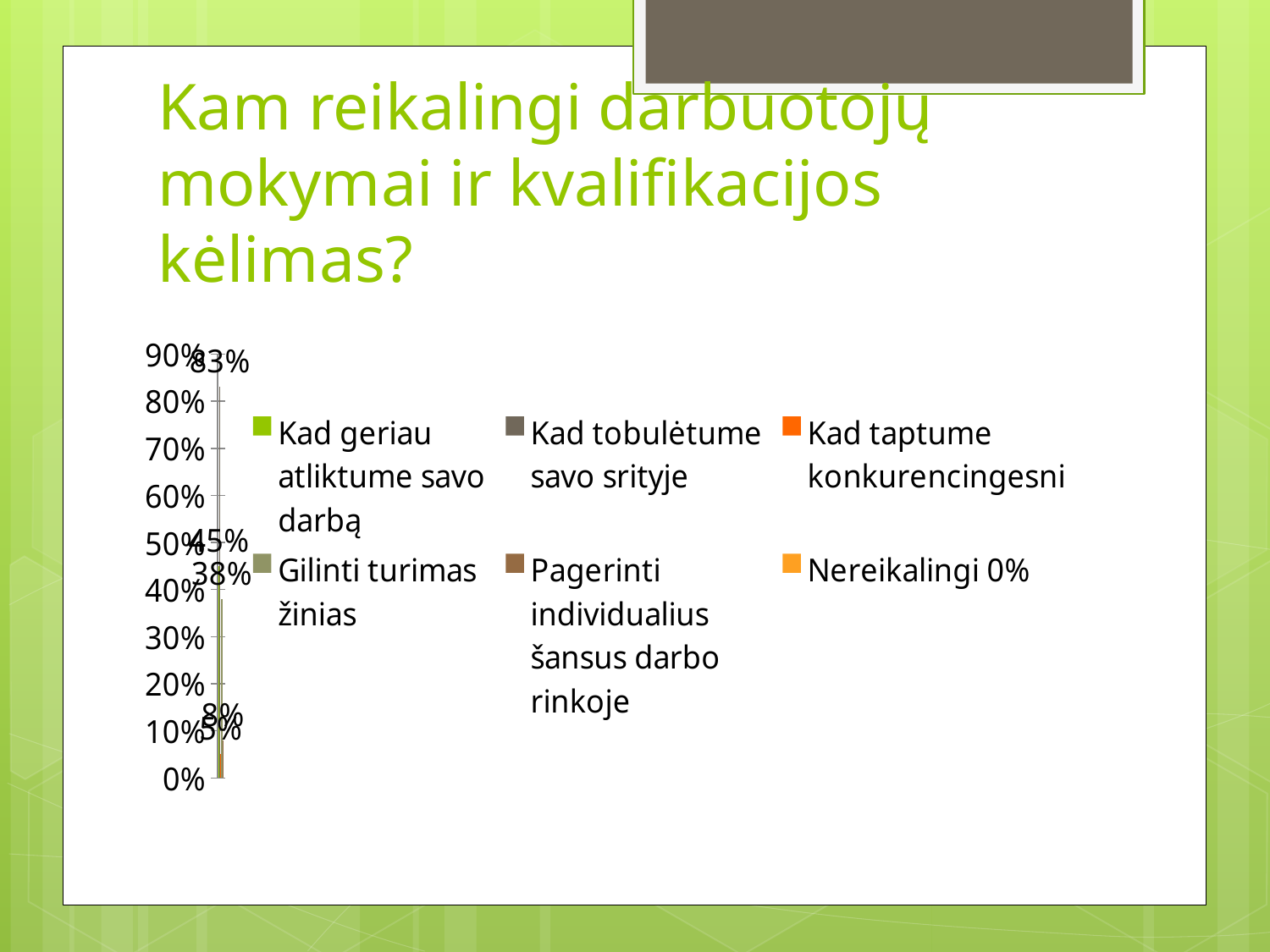
What is the highest tick value shown on the chart's vertical axis? 90% Which legend entry is shown in green? Kad geriau atliktume savo darbą What kind of chart is shown on the slide? bar chart How many series does the chart legend list? 6 What is the largest data label shown on the chart? 83% What value is given for the series "Nereikalingi"? 0%